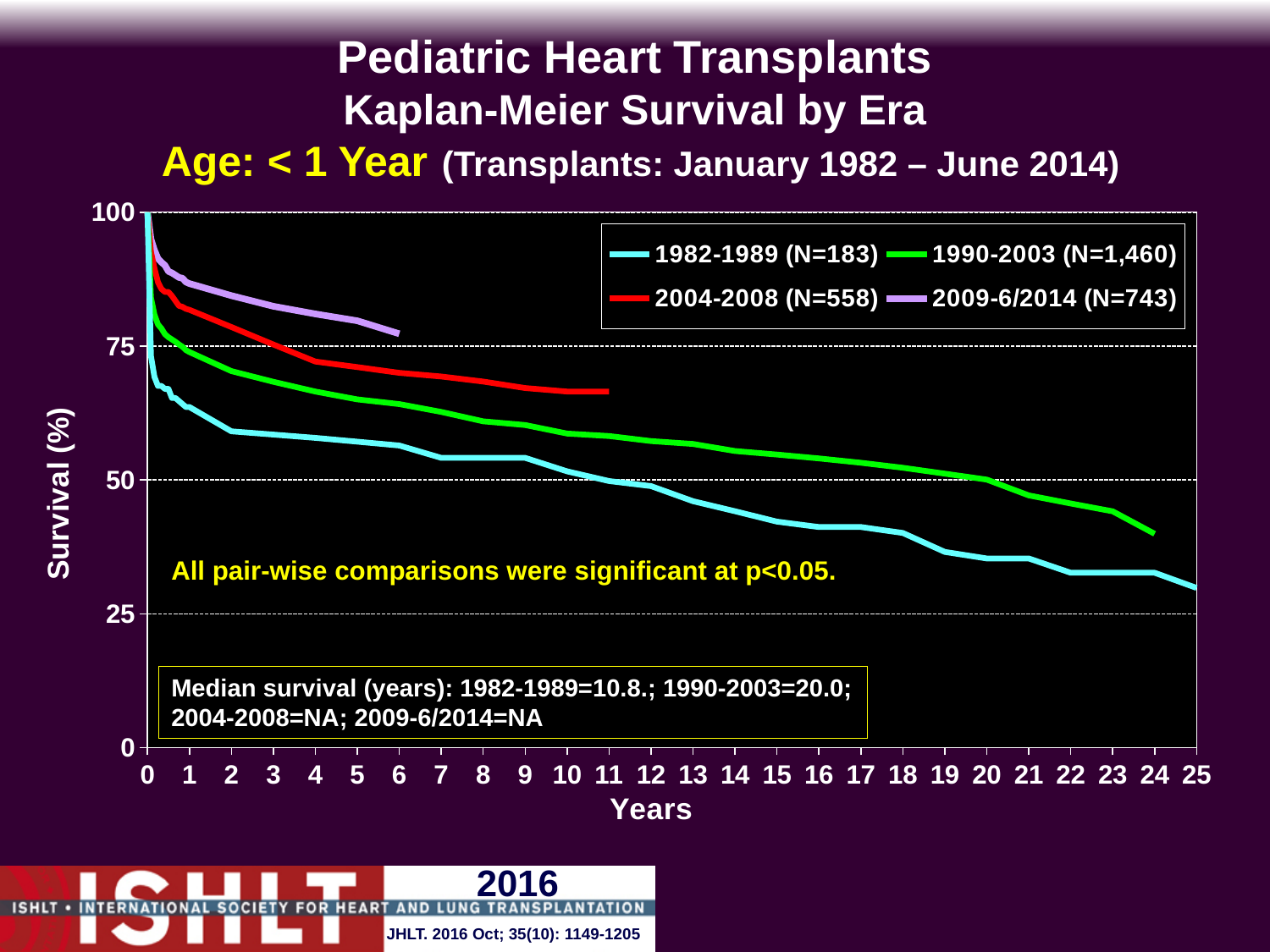
Is the survival value for the 1990-2003 era at 24 years greater or less than 50? less What type of chart is shown on the slide? Line chart Do the survival curves rise or fall as years since transplant increase? fall Which era has the highest survival curve on the chart? 2009-6/2014 Is the survival value for the 1982-1989 era at 25 years greater or less than 50? less Is the survival value for the 2009-6/2014 era at 5 years greater or less than 75? greater What is the median survival in years for the 1982-1989 era, as printed on the slide? 10.8 How many series (eras) does the legend list? 4 Which era has the lowest survival curve on the chart? 1982-1989 At 10 years, which era has higher survival: 2004-2008 or 1982-1989? 2004-2008 According to the legend, what is the N for the 1990-2003 era? 1,460